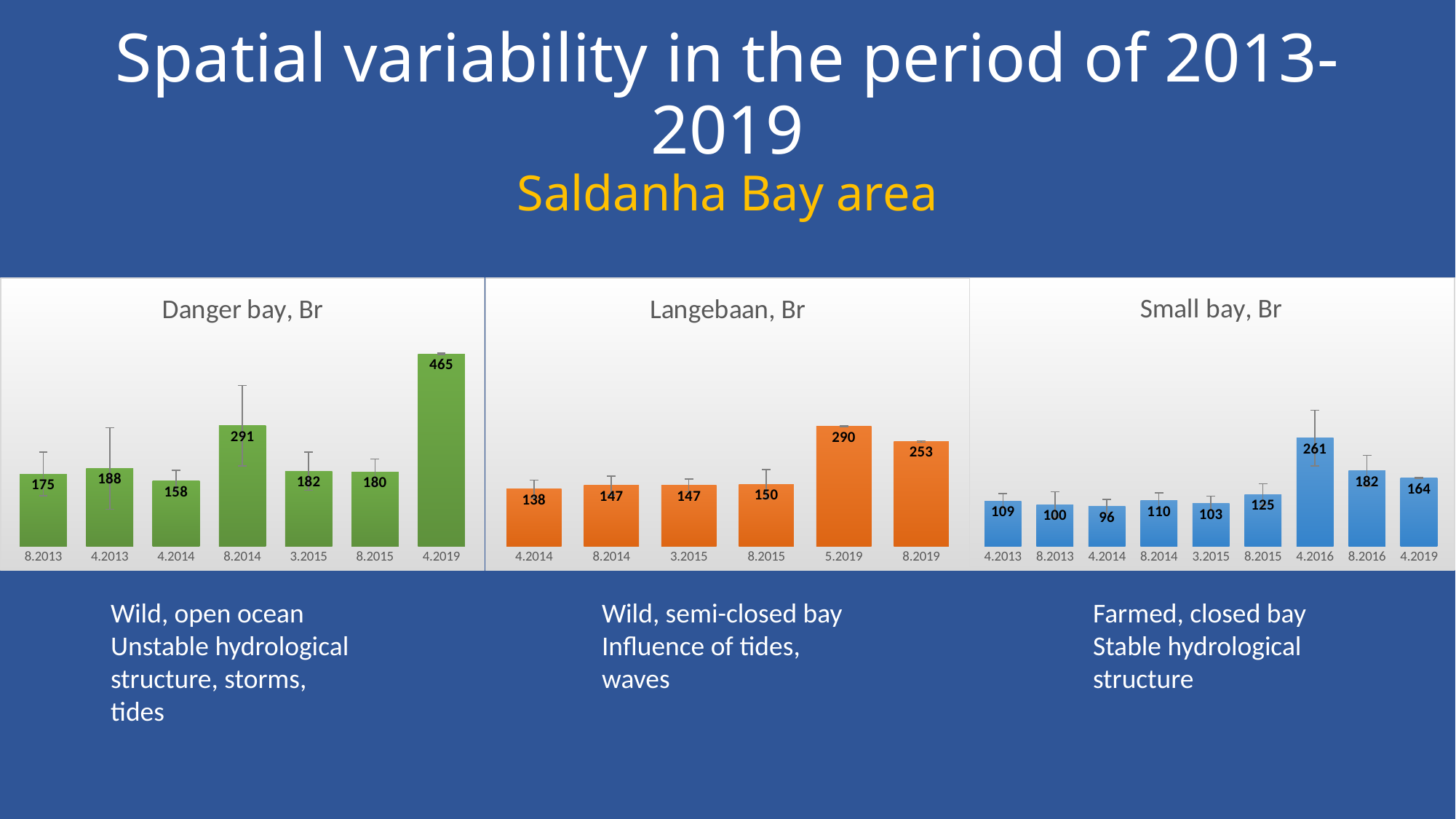
In the 'Danger bay, Br' chart, how many categories are shown on the x axis? 7 In the 'Langebaan, Br' chart, which category has the lowest value? 4.2014 In the 'Danger bay, Br' chart, which category has the highest value? 4.2019 In the 'Danger bay, Br' chart, which category has the lowest value? 4.2014 What type of chart is the 'Small bay, Br' chart? Bar chart In the 'Small bay, Br' chart, how many categories are shown on the x axis? 9 In the 'Langebaan, Br' chart, what is the value for 5.2019? 290 In the 'Langebaan, Br' chart, what is the difference between the values for 8.2019 and 4.2014? 115 Which is larger: the value for 8.2015 in the 'Danger bay, Br' chart or the value for 8.2015 in the 'Langebaan, Br' chart? Danger bay, Br (180) In the 'Danger bay, Br' chart, what is the value for 8.2014? 291 In the 'Small bay, Br' chart, what is the value for 4.2016? 261 In the 'Small bay, Br' chart, which category has the lowest value? 4.2014